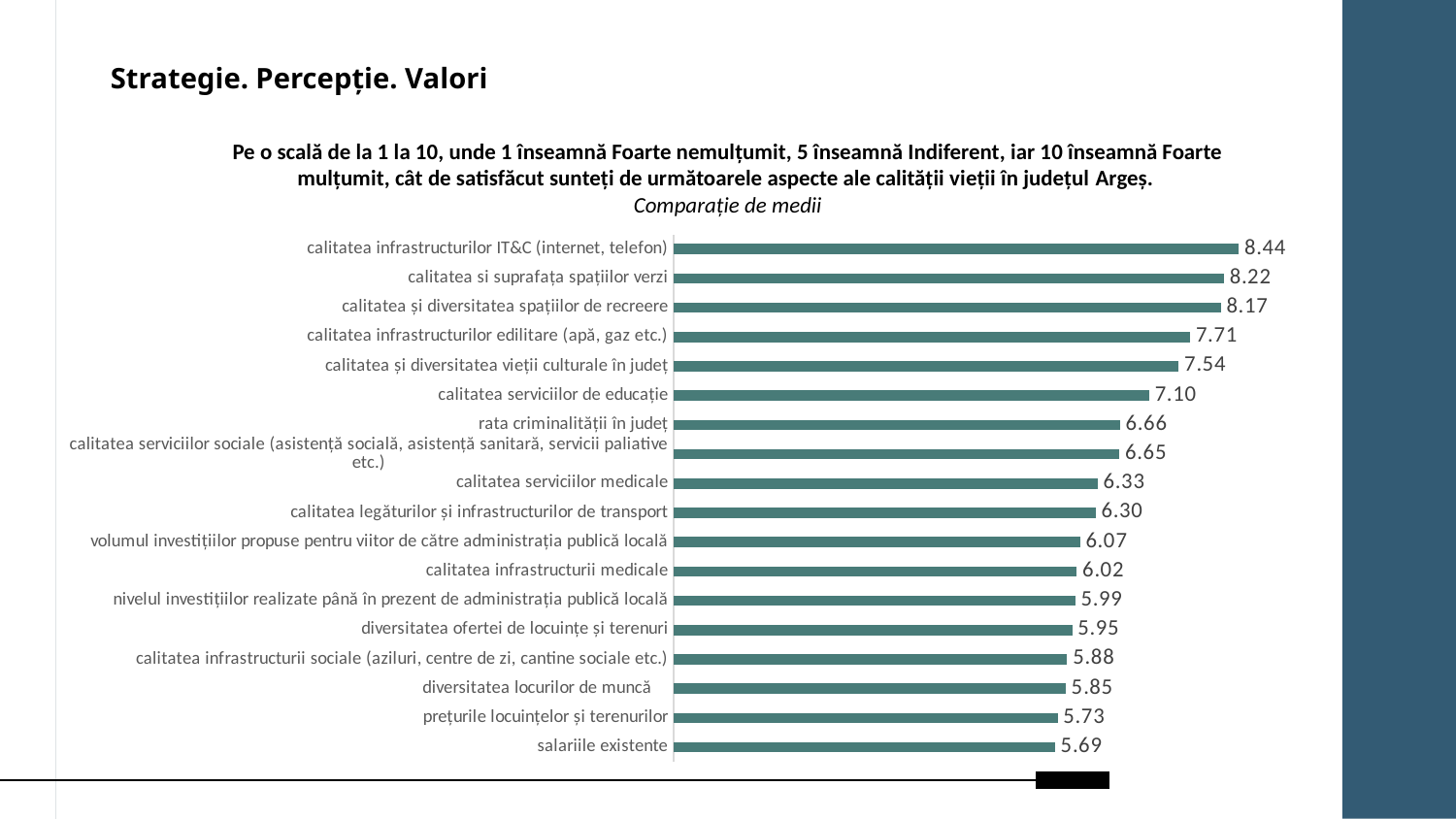
What is the value shown for 'calitatea infrastructurii medicale'? 6.02 What type of chart is shown on the slide? bar chart Which aspect has the lowest average satisfaction score? salariile existente Which has a higher score: 'calitatea serviciilor medicale' or 'calitatea legăturilor și infrastructurilor de transport'? calitatea serviciilor medicale What is the difference between the scores for 'calitatea si suprafața spațiilor verzi' and 'calitatea și diversitatea spațiilor de recreere'? 0.05 What is the difference between the highest and lowest scores on the chart? 2.75 How many aspects (categories) are shown on the chart? 18 What is the value shown for 'salariile existente'? 5.69 What is the value shown for 'calitatea serviciilor de educație'? 7.10 What is the average satisfaction score for 'calitatea infrastructurilor IT&C (internet, telefon)'? 8.44 Which aspect has the highest average satisfaction score? calitatea infrastructurilor IT&C (internet, telefon) What is the subtitle shown in italics below the chart's question text? Comparație de medii